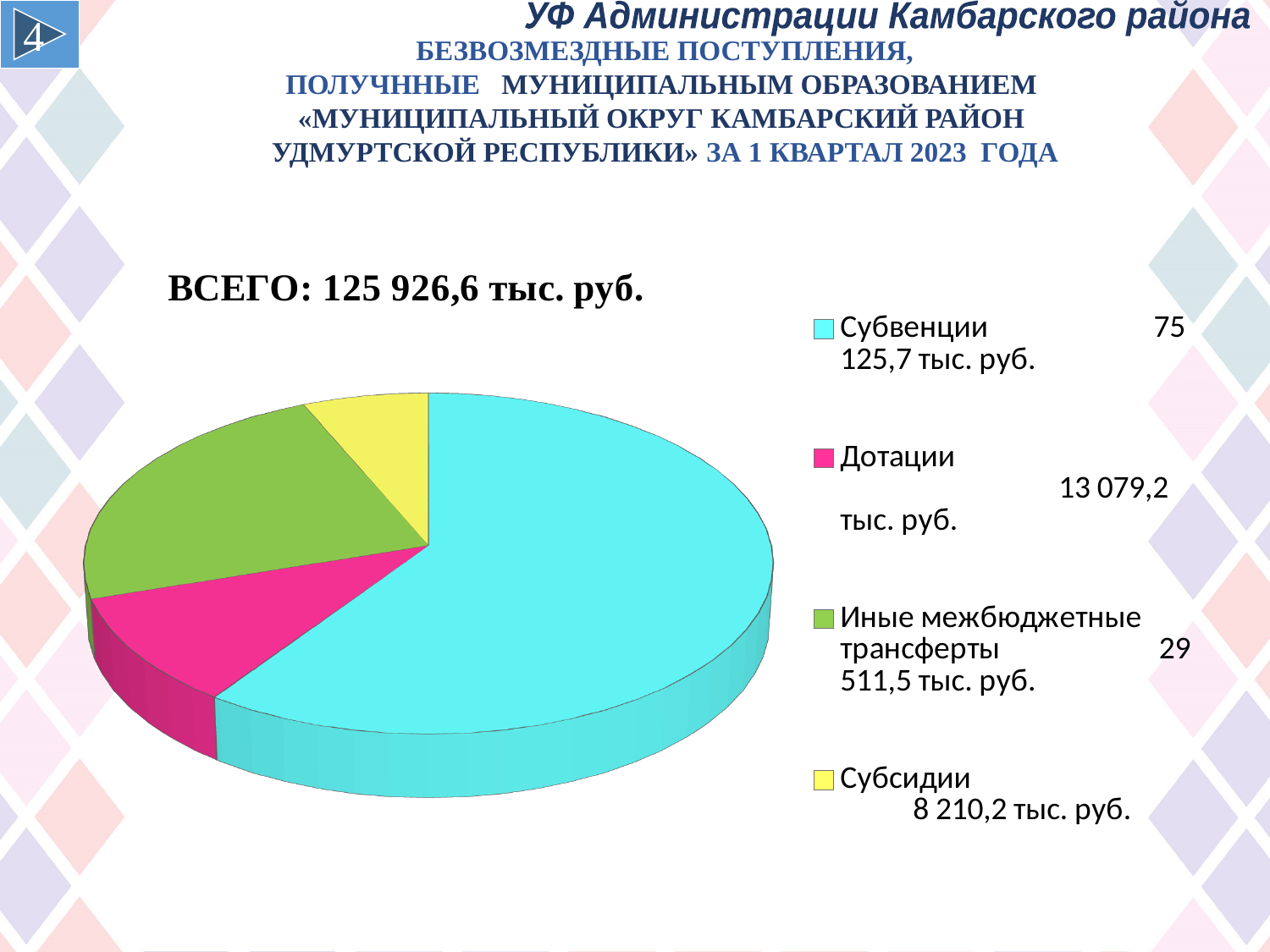
What colour is the slice for Дотации? pink What is the value for Дотации? 13 079,2 тыс. руб. What is the value for Иные межбюджетные трансферты? 29 511,5 тыс. руб. How many slices does the pie chart have? 4 What is the total (ВСЕГО) shown for all categories? 125 926,6 тыс. руб. What is the value for Субсидии? 8 210,2 тыс. руб. What is the difference between Субвенции and Дотации? 62 046,5 тыс. руб. Which category has the largest slice of the pie? Субвенции What is the value for Субвенции? 75 125,7 тыс. руб. Which category has the smallest slice of the pie? Субсидии Which is larger, Иные межбюджетные трансферты or Дотации? Иные межбюджетные трансферты What kind of chart is shown on the slide? pie chart